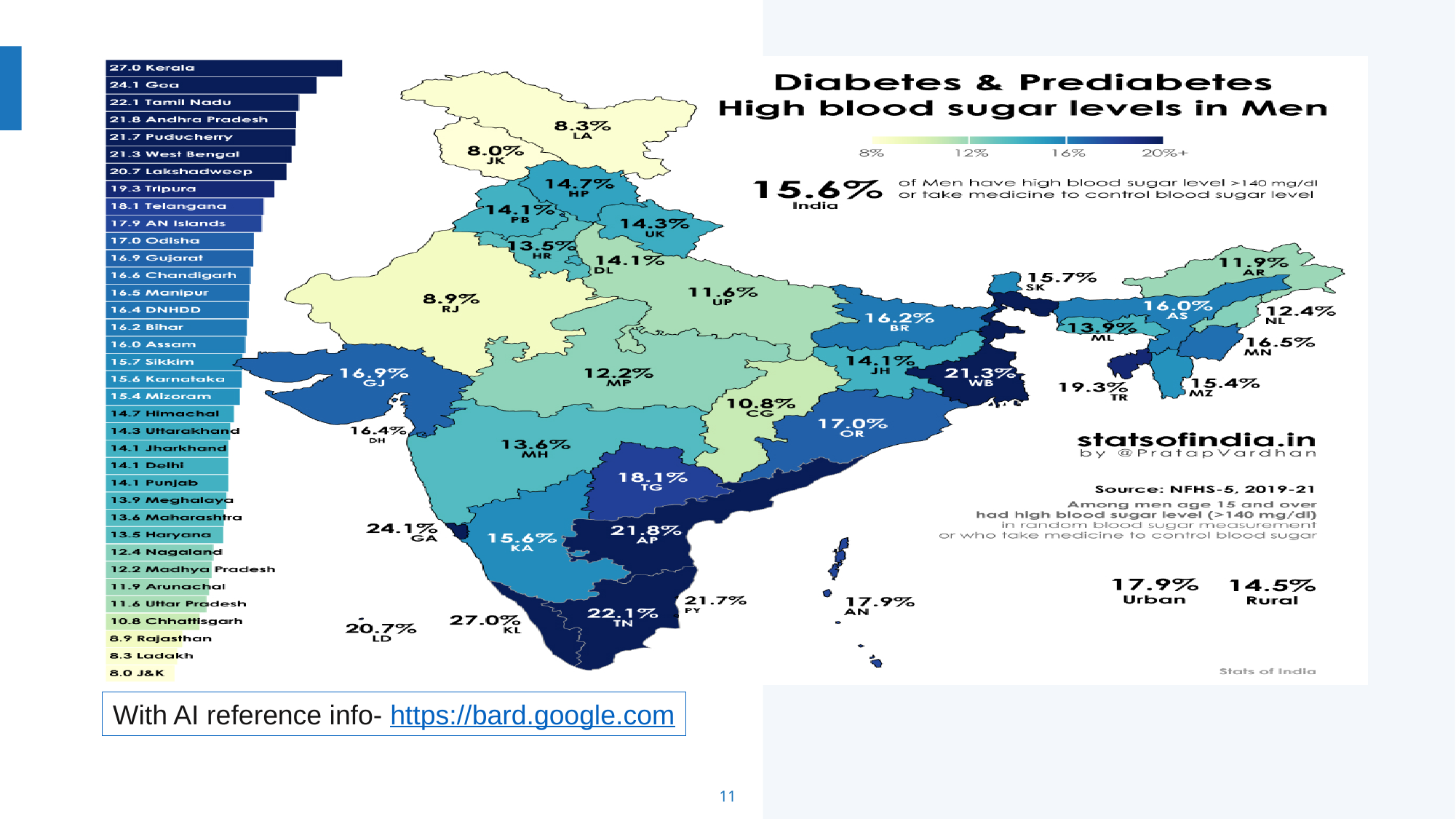
What kind of chart is shown on the left of the slide? Bar chart On the map, what is the difference between the Urban and Rural percentages? 3.4% In the bar chart on the left, what is the value for Chhattisgarh? 10.8 In the bar chart on the left, which has a larger value, Telangana or Odisha? Telangana In the bar chart on the left, what is the value for Goa? 24.1 On the map, what is the percentage shown for Urban men? 17.9% In the bar chart on the left, what is the difference between the values for Kerala and Tamil Nadu? 4.9 How many states or territories are listed in the bar chart on the left? 36 What is the title of the map on the right? Diabetes & Prediabetes High blood sugar levels in Men In the bar chart on the left, which state has the highest value? Kerala In the bar chart on the left, which state has the lowest value? J&K On the map, what is the percentage shown for India overall? 15.6%